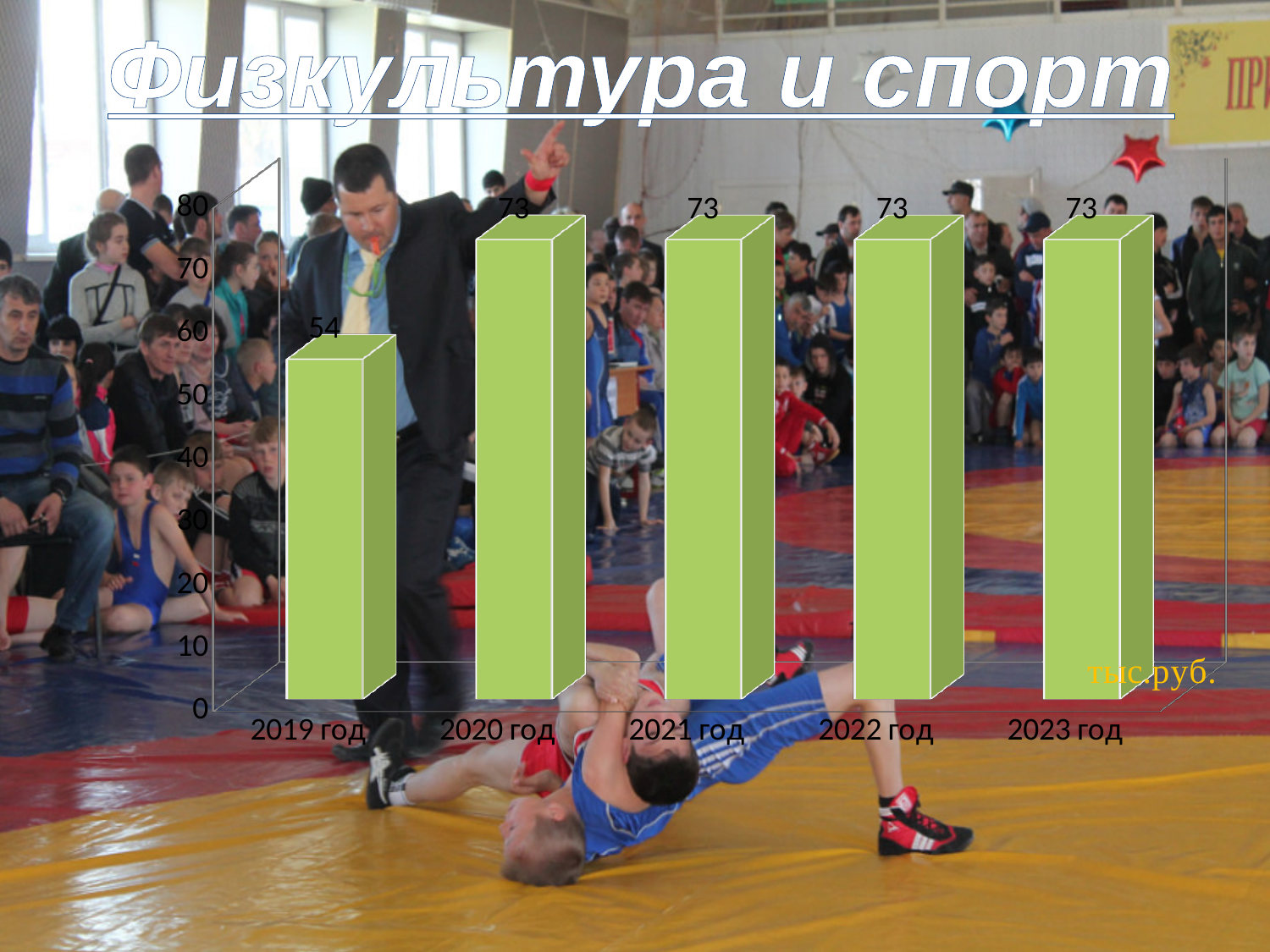
Do the values rise or fall from 2019 год to 2020 год? rise How many years are shown on the x axis? 5 What is the difference between the values for 2020 год and 2019 год? 19 What kind of chart is shown on the slide? bar chart Which year has the lowest value? 2019 год What is the value for 2023 год? 73 What is the value for 2019 год? 54 Is the value for 2019 год greater or less than 60? less What is the value for 2021 год? 73 Is the value for 2020 год greater or less than 70? greater Which is larger, the value for 2019 год or the value for 2022 год? 2022 год What unit is indicated next to the chart? тыс.руб.